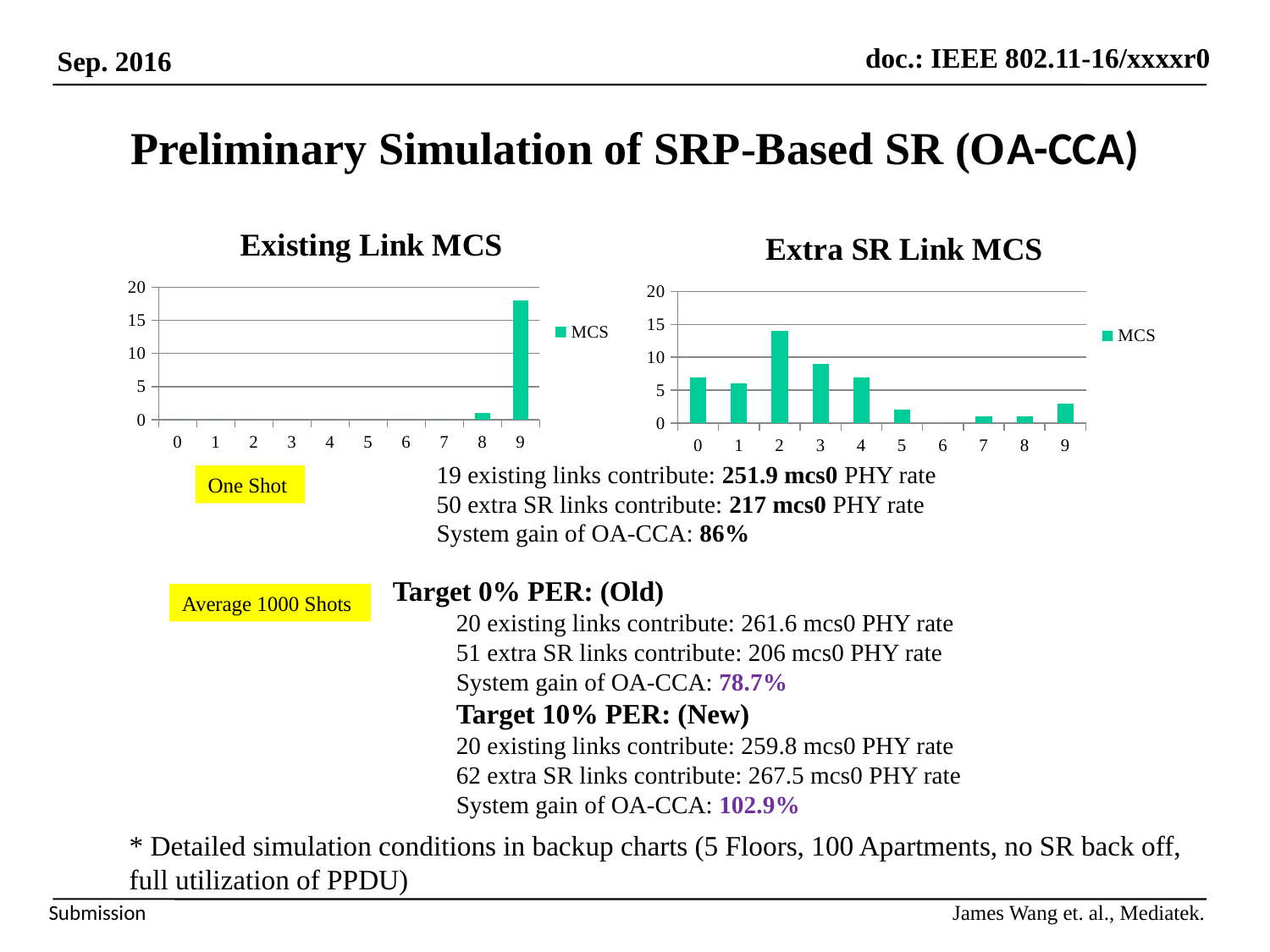
In the "Existing Link MCS" chart, which MCS category has the highest value? 9 What is the legend entry shown for the "Existing Link MCS" chart? MCS In the "Extra SR Link MCS" chart, is the value for MCS 3 greater or less than 5? greater In the "Extra SR Link MCS" chart, is the value for MCS 2 greater or less than 10? greater In the "Extra SR Link MCS" chart, which MCS category has the highest value? 2 How many series does the legend of the "Extra SR Link MCS" chart list? 1 In the "Extra SR Link MCS" chart, which is larger, the value for MCS 3 or the value for MCS 9? MCS 3 What kind of chart is the "Existing Link MCS" chart? bar chart In the "Existing Link MCS" chart, is the value for MCS 8 greater or less than 5? less In the "Extra SR Link MCS" chart, which is larger, the value for MCS 2 or the value for MCS 5? MCS 2 How many MCS categories are shown on the x axis of the "Existing Link MCS" chart? 10